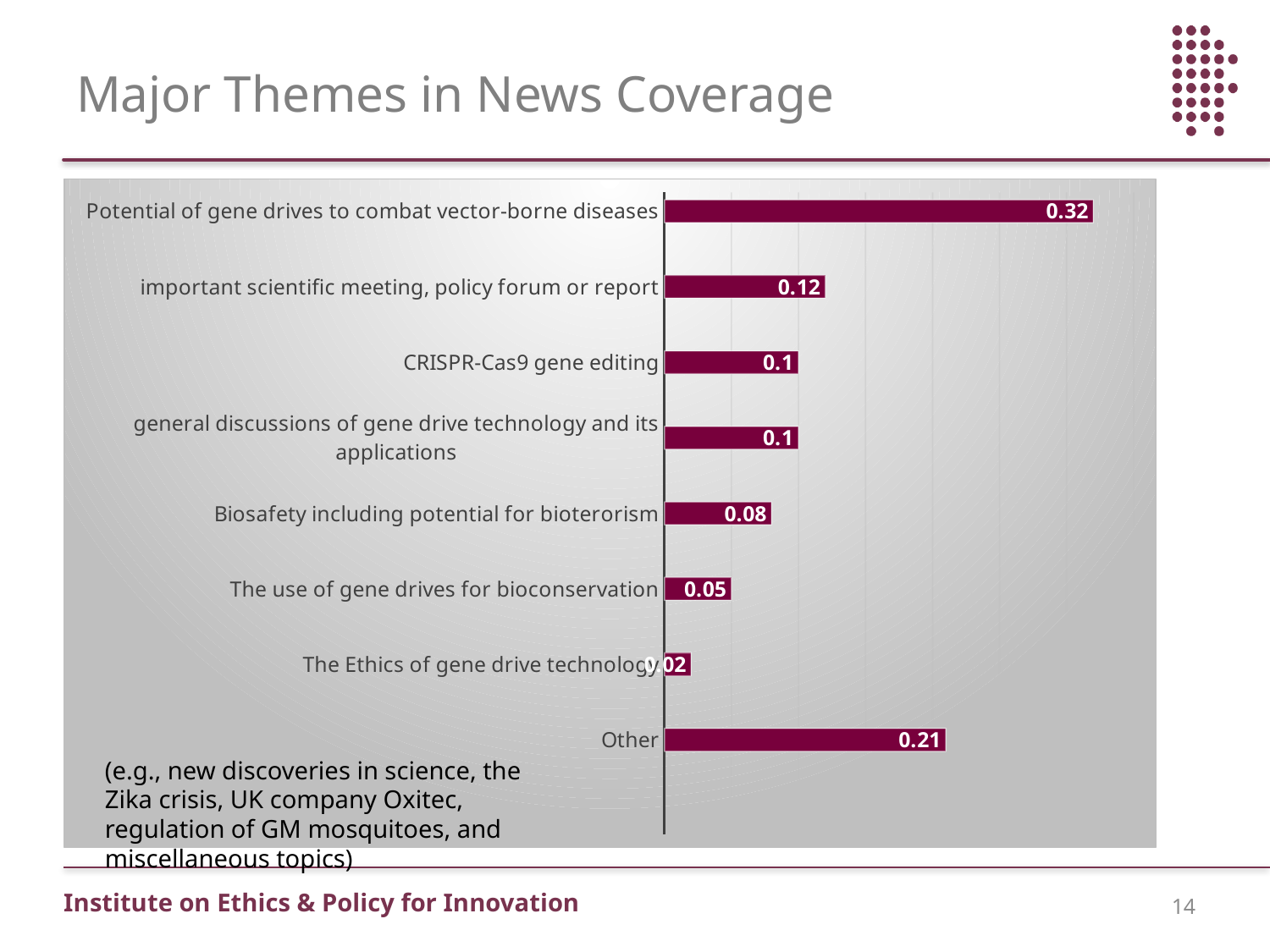
What is the value for "The use of gene drives for bioconservation"? 0.05 Which is larger: the value for "Other" or the value for "important scientific meeting, policy forum or report"? Other What is the value for "Other"? 0.21 Which category has the lowest value? The Ethics of gene drive technology What is the value for "CRISPR-Cas9 gene editing"? 0.1 What is the value for "important scientific meeting, policy forum or report"? 0.12 Which category has the highest value? Potential of gene drives to combat vector-borne diseases What kind of chart is shown on the slide? bar chart How many categories are shown in the chart? 8 What is the value for "Biosafety including potential for bioterorism"? 0.08 What is the difference between the values for "Potential of gene drives to combat vector-borne diseases" and "Other"? 0.11 What is the value for "Potential of gene drives to combat vector-borne diseases"? 0.32